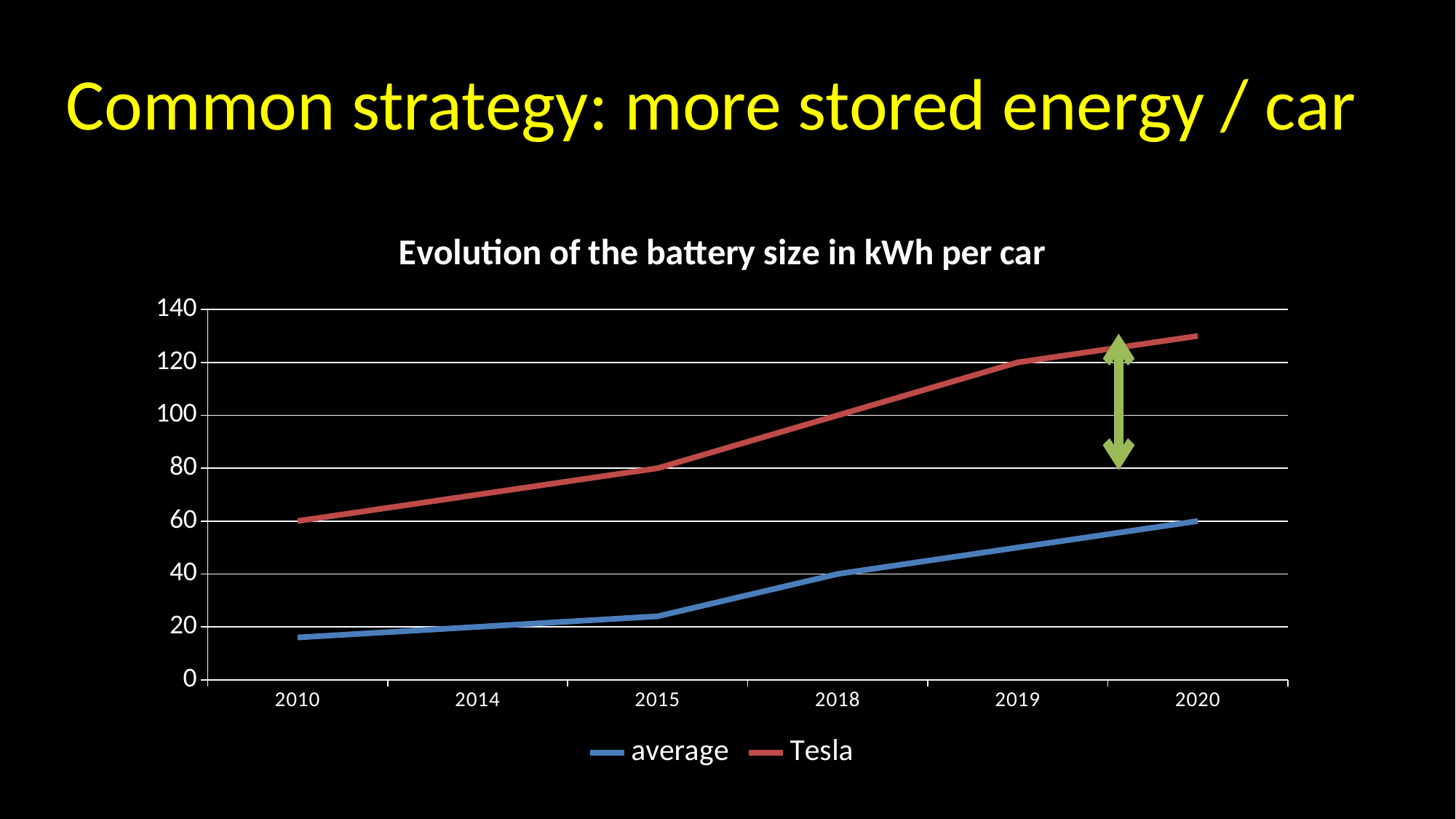
What is the title of the chart? Evolution of the battery size in kWh per car Do the Tesla values rise or fall from 2010 to 2020? rise Is the average value in 2010 greater or less than 20? less What is the average value in 2020? 60 Which series is higher in 2018, average or Tesla? Tesla How many years are shown on the x axis? 6 Is the Tesla value in 2020 greater or less than 120? greater How many series does the legend list? 2 What kind of chart is shown on the slide? line chart What is the Tesla value in 2015? 80 What is the Tesla value in 2019? 120 What is the Tesla value in 2010? 60